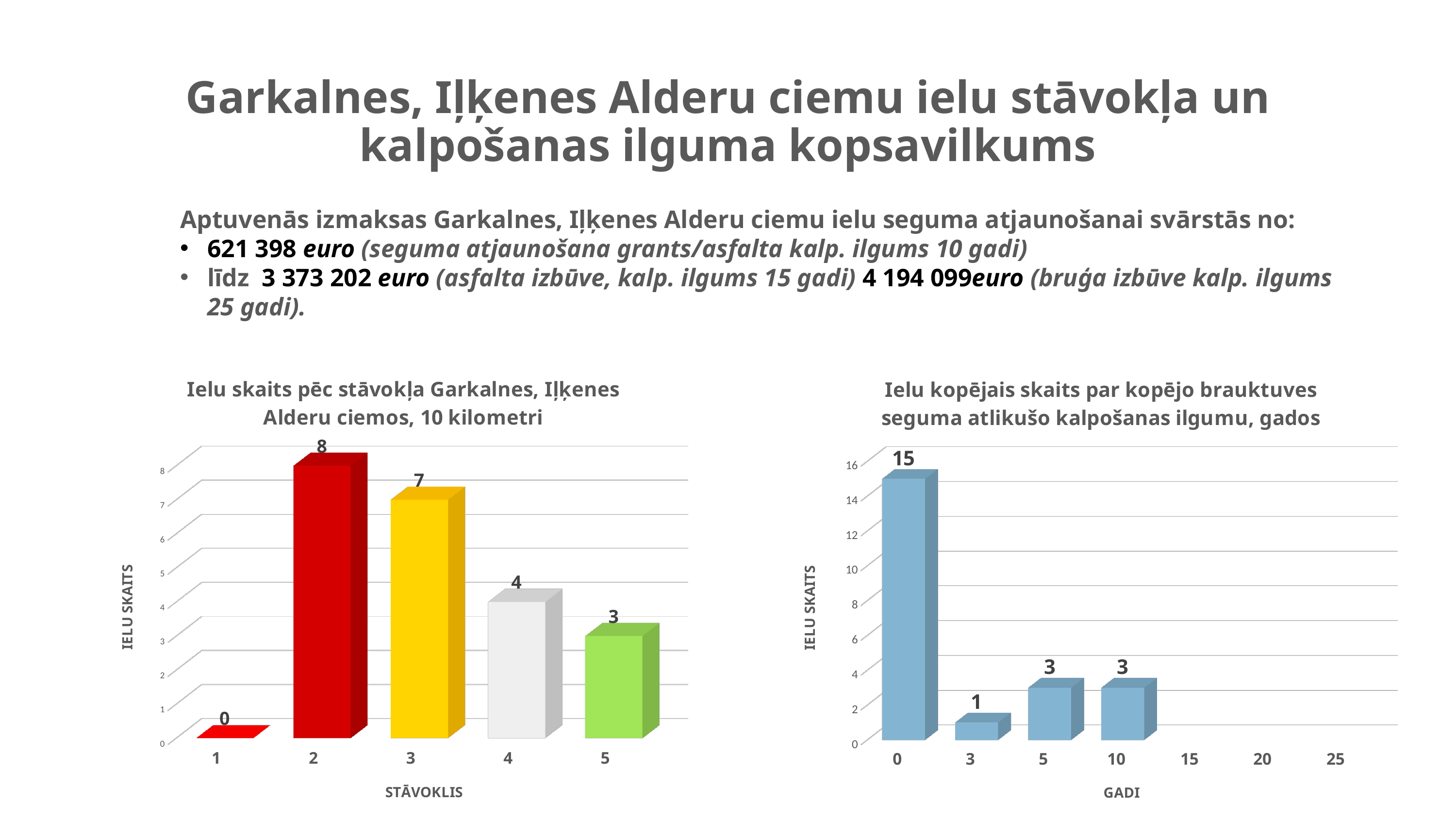
In the right chart (Ielu kopējais skaits par kopējo brauktuves seguma atlikušo kalpošanas ilgumu), what is the difference between the values for 0 years and 10 years? 12 In the left chart (Ielu skaits pēc stāvokļa), what is the value for condition category 4? 4 In the left chart (Ielu skaits pēc stāvokļa), what is the value for condition category 2? 8 In the left chart (Ielu skaits pēc stāvokļa), what is the difference between the values for categories 2 and 5? 5 In the right chart (Ielu kopējais skaits par kopējo brauktuves seguma atlikušo kalpošanas ilgumu), which is larger, the value for 5 years or the value for 3 years? 5 years In the left chart (Ielu skaits pēc stāvokļa), how many condition categories are shown on the x axis? 5 In the left chart (Ielu skaits pēc stāvokļa), which condition category has the highest number of streets? 2 In the right chart (Ielu kopējais skaits par kopējo brauktuves seguma atlikušo kalpošanas ilgumu), what is the value for 3 years? 1 What kind of chart is the right chart (Ielu kopējais skaits par kopējo brauktuves seguma atlikušo kalpošanas ilgumu)? Bar chart In the right chart (Ielu kopējais skaits par kopējo brauktuves seguma atlikušo kalpošanas ilgumu), what is the value for 0 years? 15 In the left chart (Ielu skaits pēc stāvokļa), which condition category has the lowest number of streets? 1 What is the y-axis label of the left chart (Ielu skaits pēc stāvokļa)? IELU SKAITS